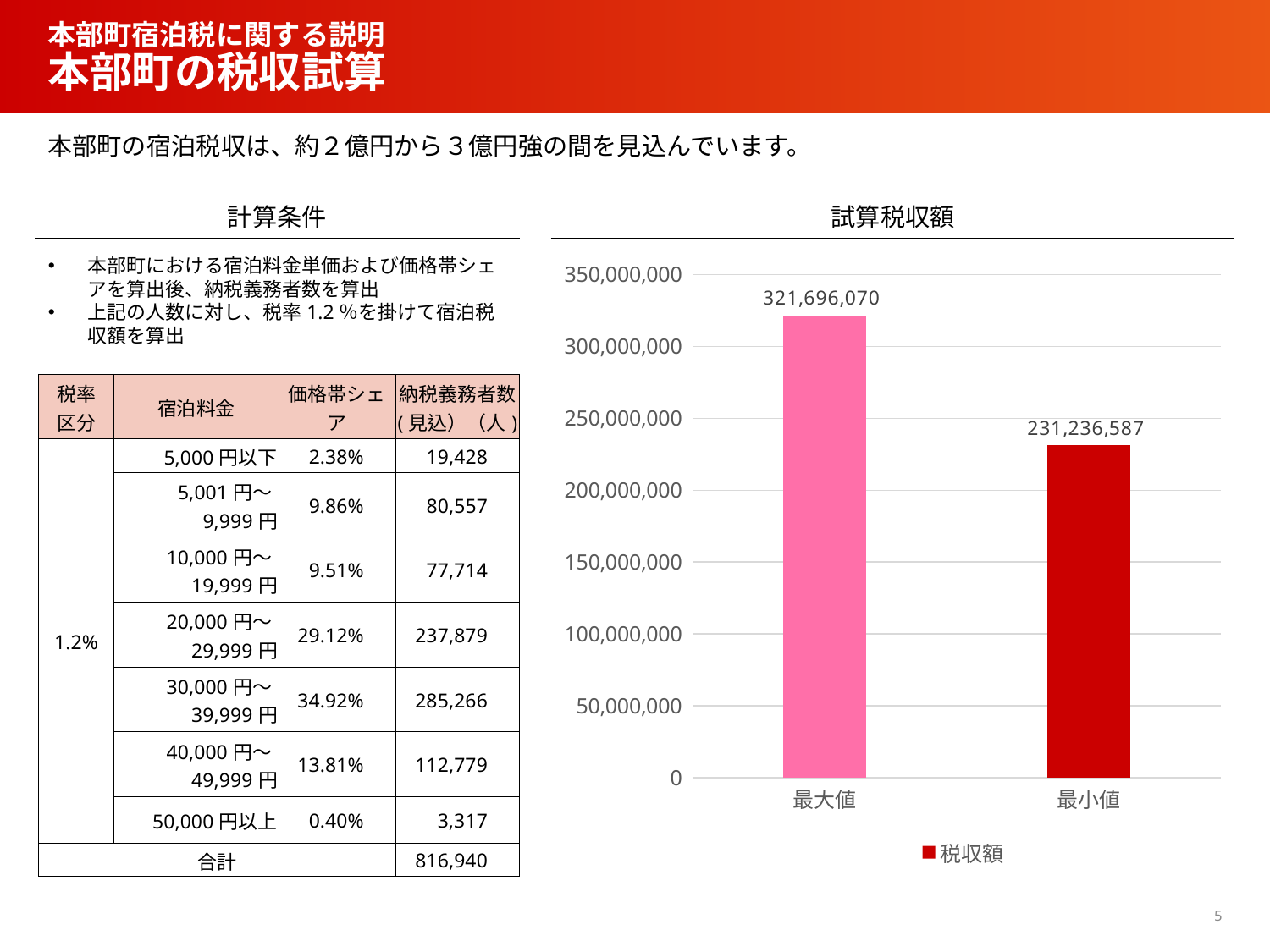
What is the value of the 最小値 bar in the 試算税収額 chart? 231,236,587 Is the value for 最小値 in the 試算税収額 chart greater or less than 250,000,000? less What type of chart is the 試算税収額 chart? bar chart In the 試算税収額 chart, which is larger, 最大値 or 最小値? 最大値 Which category has the highest value in the 試算税収額 chart? 最大値 What is the legend entry shown below the 試算税収額 chart? 税収額 What is the difference between the 最大値 and 最小値 bars in the 試算税収額 chart? 90,459,483 Which category has the lowest value in the 試算税収額 chart? 最小値 What is the value of the 最大値 bar in the 試算税収額 chart? 321,696,070 How many series does the legend of the 試算税収額 chart list? 1 Is the value for 最大値 in the 試算税収額 chart greater or less than 300,000,000? greater How many bars are shown in the 試算税収額 chart? 2